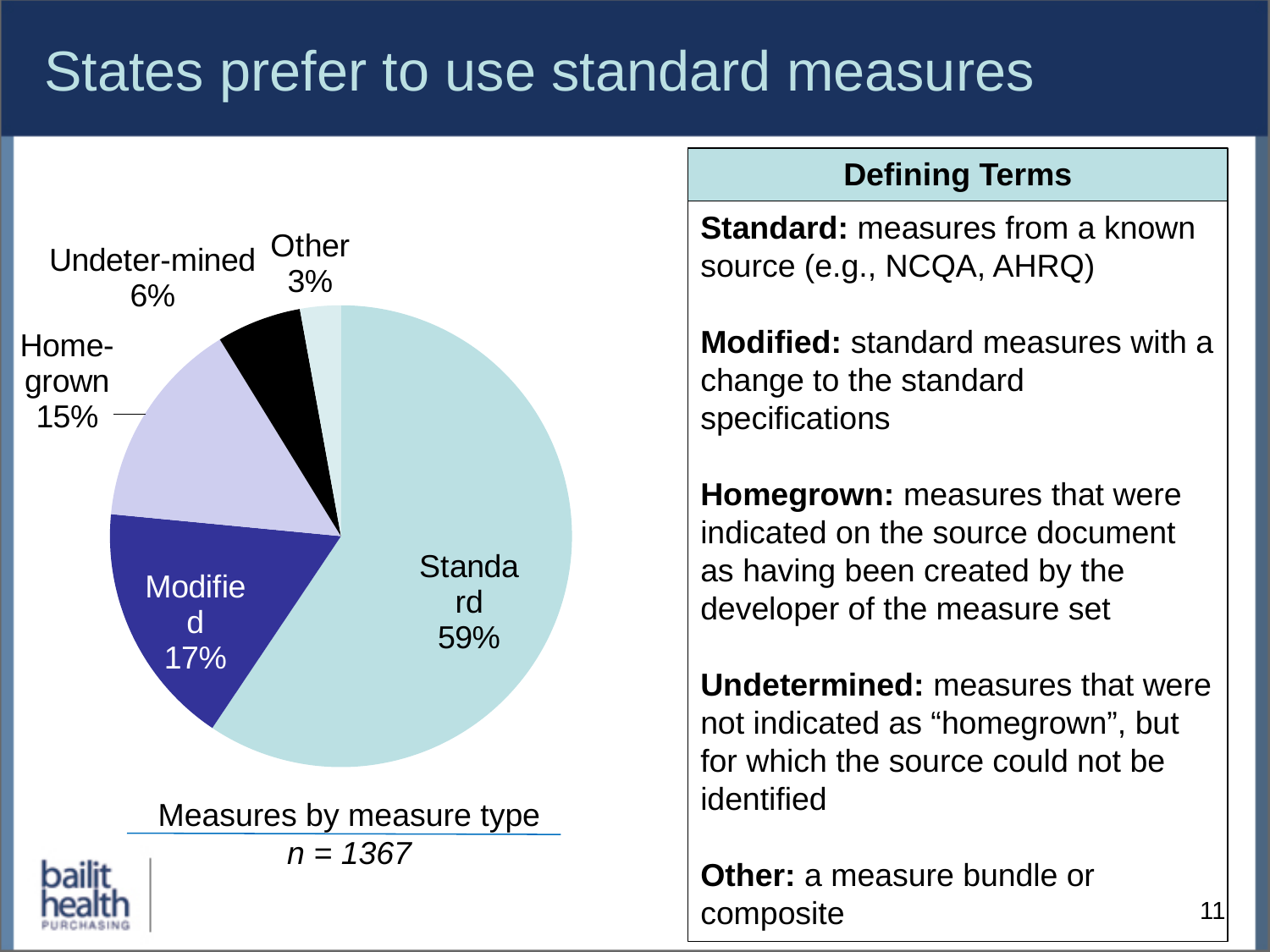
Which measure type has the smallest share of the pie? Other Which is larger, the Homegrown share or the Undetermined share? Homegrown Which measure type has the largest share of the pie? Standard What share of measures are Homegrown? 15% How many slices does the pie chart have? 5 What is the difference in percentage points between the Standard and Modified shares? 42 What share of measures are Undetermined? 6% What share of measures are Standard? 59% What is the sample size (n) stated below the pie chart? n = 1367 What type of chart is shown on the slide? pie chart